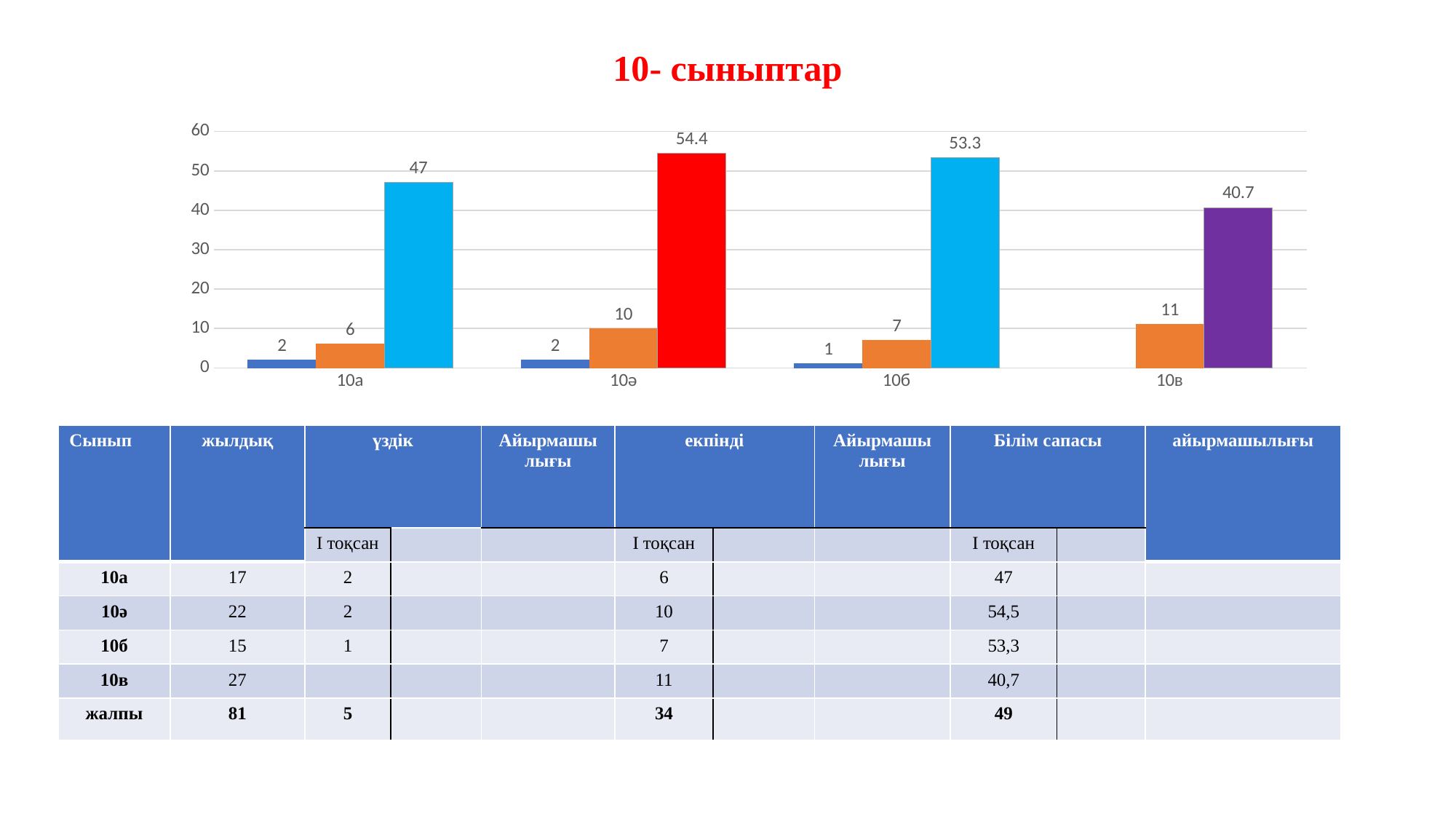
What is the value of the red bar for category 10ә? 54.4 What type of chart is shown on the slide? bar chart What is the value of the purple bar for category 10в? 40.7 What is the title of the slide above the chart? 10- сыныптар How many categories are shown on the x axis of the chart? 4 Is the tallest bar for category 10б greater or less than 50? greater What is the value of the blue (first) bar for category 10б? 1 Which category has the highest bar in the chart? 10ә What is the value of the tallest bar for category 10а? 47 What is the difference between the tallest bar for 10ә (54.4) and the tallest bar for 10в (40.7)? 13.7 Which is larger: the orange bar for 10ә or the orange bar for 10б? 10ә What is the value of the orange bar for category 10в? 11